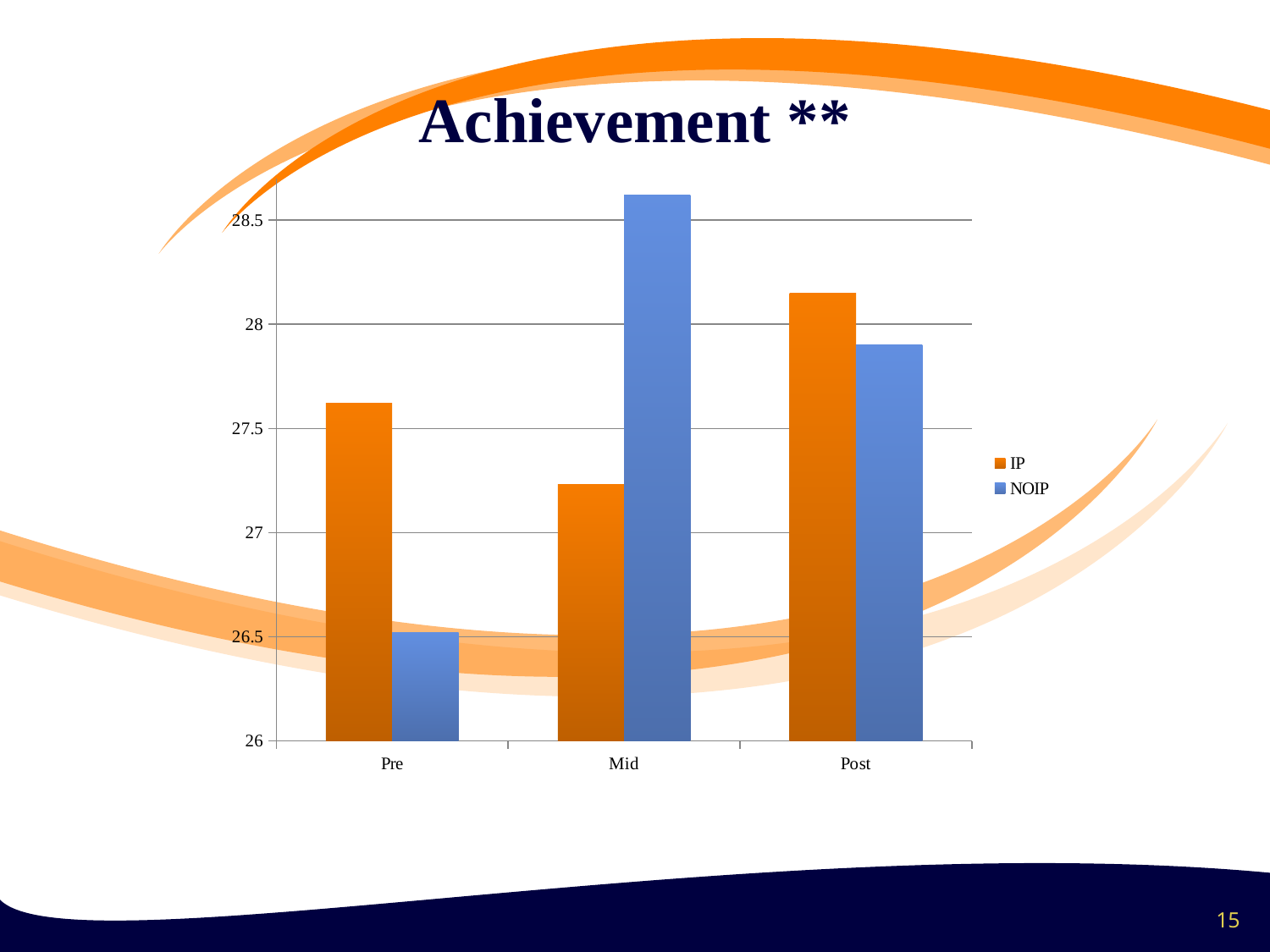
Which category has the highest IP value? Post Which colour represents the NOIP series in the legend? blue What kind of chart is shown on the slide? bar chart Is the NOIP value for Mid greater or less than 28.5? greater Which category has the lowest IP value? Mid Which category has the lowest NOIP value? Pre At Mid, which series has the larger value, IP or NOIP? NOIP Which category has the highest NOIP value? Mid Is the IP value for Pre greater or less than 27.5? greater How many categories are shown on the x axis? 3 How many series does the legend list? 2 At Pre, which series has the larger value, IP or NOIP? IP